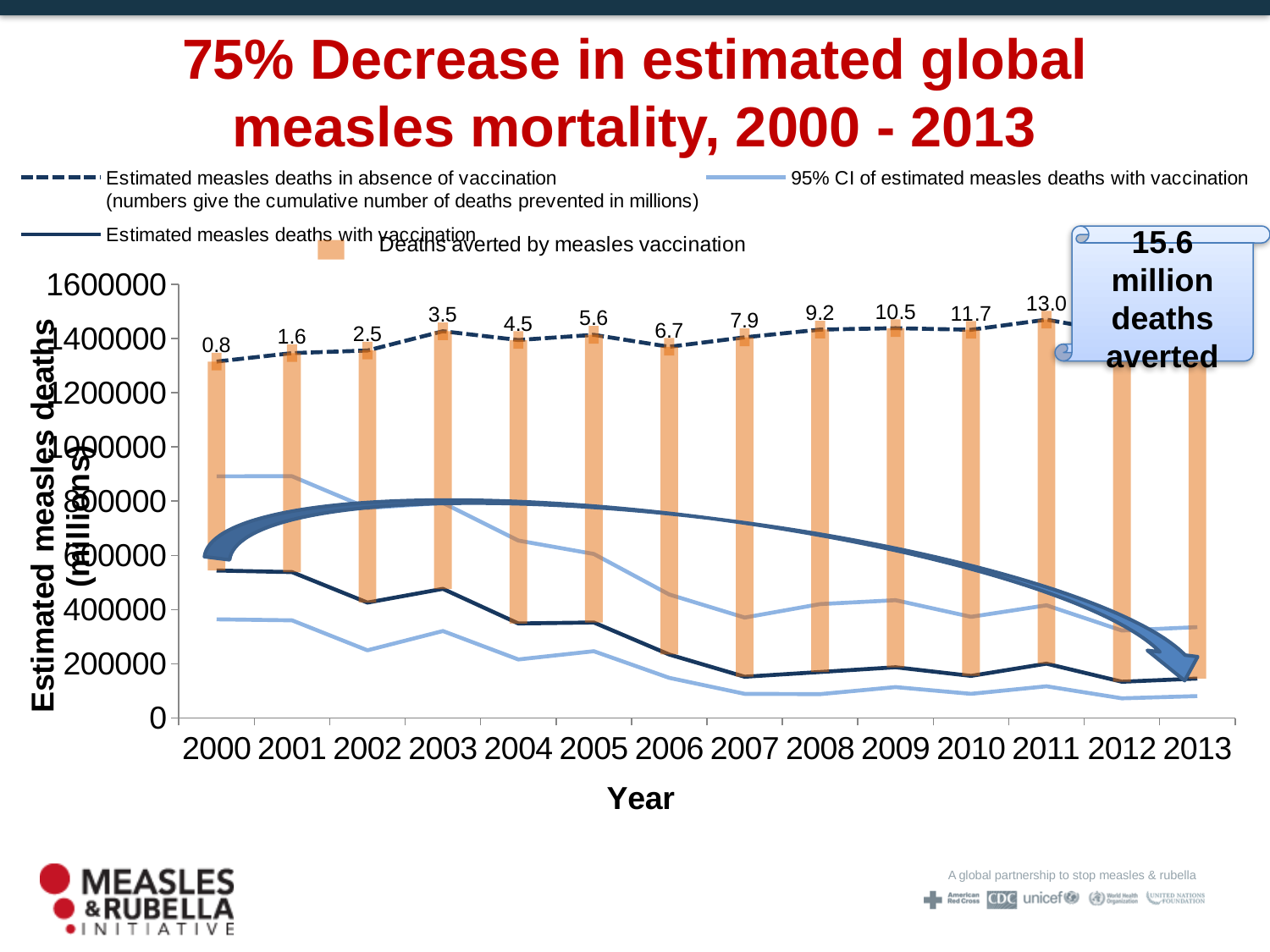
What cumulative number of deaths prevented (in millions) is labelled for 2008? 9.2 What cumulative number of deaths prevented (in millions) is labelled for 2003? 3.5 What is the difference between the cumulative deaths prevented labels for 2011 and 2000? 12.2 What is the title of the x axis? Year How many years are shown on the x axis? 14 What cumulative number of deaths prevented (in millions) is labelled for 2011? 13.0 Which year has the lowest cumulative deaths prevented label on the chart? 2000 Is the value of estimated measles deaths with vaccination in 2000 greater or less than 400000? greater Which is larger, the cumulative deaths prevented label for 2007 or for 2004? 2007 According to the callout on the chart, how many deaths were averted? 15.6 million Is the value of estimated measles deaths with vaccination in 2013 greater or less than 200000? less Do the cumulative deaths prevented labels rise or fall from 2000 to 2011? rise